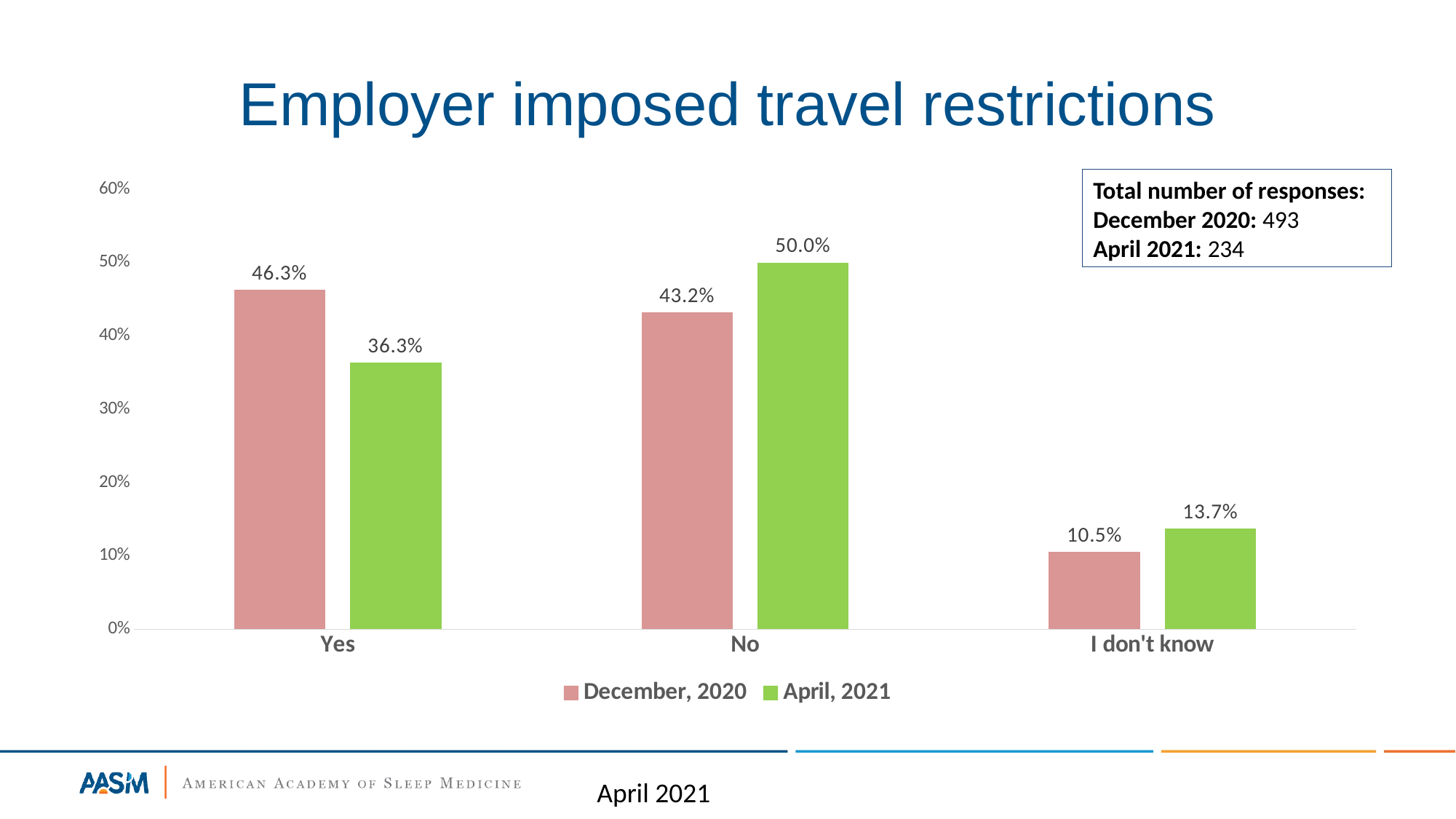
How many series does the legend list? 2 What is the value for "I don't know" in the December, 2020 series? 10.5% What is the value for "Yes" in the December, 2020 series? 46.3% Is the April, 2021 value for "I don't know" greater or less than 10%? greater How many categories are shown on the x axis? 3 What kind of chart is shown on the slide? Bar chart What is the title of the chart? Employer imposed travel restrictions Which is larger for "No": the December, 2020 value or the April, 2021 value? April, 2021 What is the difference between the December, 2020 and April, 2021 values for "Yes"? 10.0% Which category has the lowest value in the December, 2020 series? I don't know What is the value for "No" in the April, 2021 series? 50.0% Which category has the highest value in the April, 2021 series? No